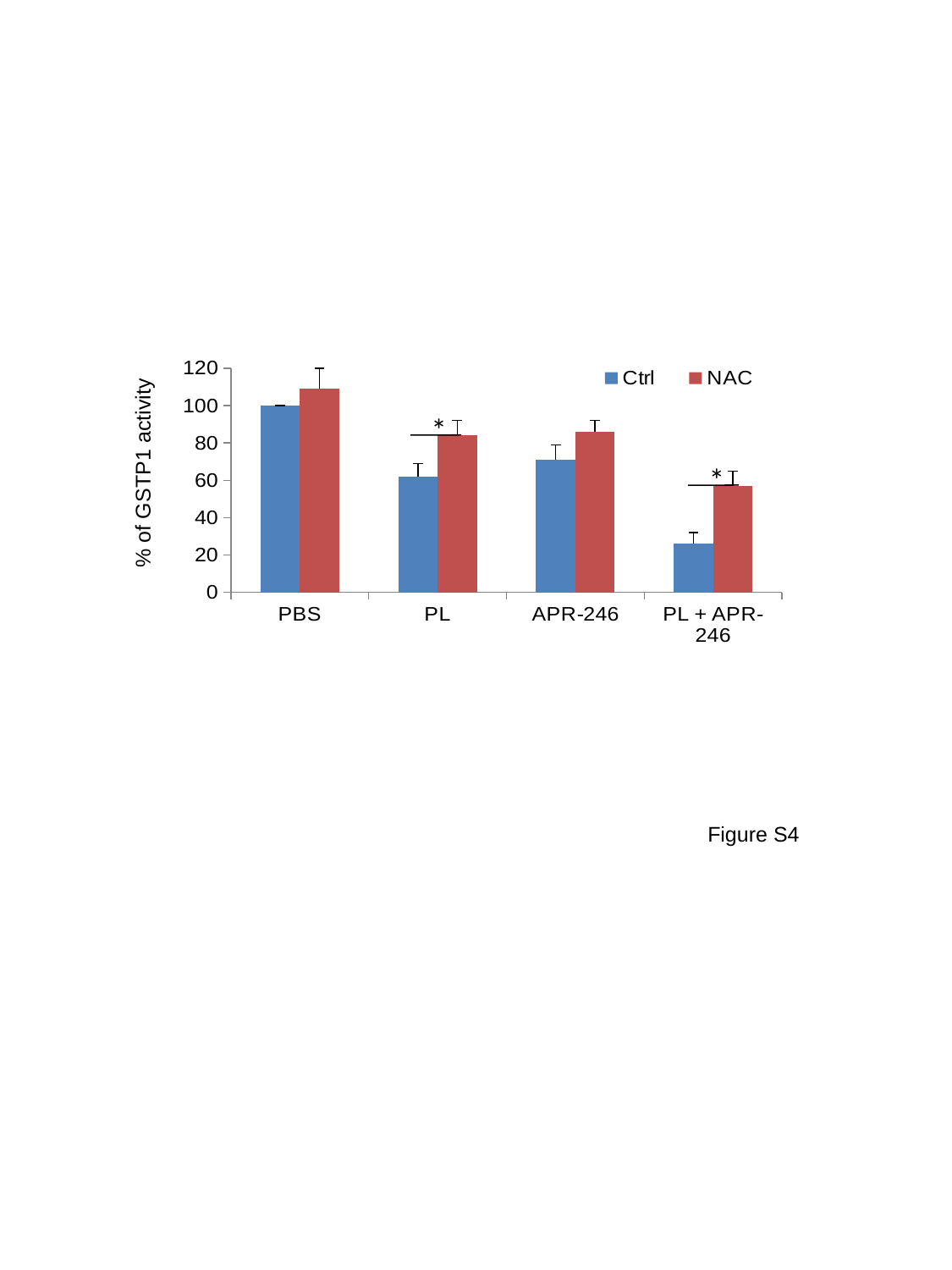
Which category has the lowest NAC value? PL + APR-246 Is the Ctrl value for PL + APR-246 greater or less than 40? less Is the Ctrl value for APR-246 greater or less than 80? less For the PL category, which is larger, the Ctrl value or the NAC value? NAC Which category has the highest Ctrl value? PBS How many series does the legend list? 2 Is the NAC value for PBS greater or less than 100? greater Which colour represents the NAC series in the legend? red What kind of chart is shown on the slide? bar chart What is the y-axis title of the chart? % of GSTP1 activity How many categories are shown on the x axis? 4 Which category has the lowest Ctrl value? PL + APR-246